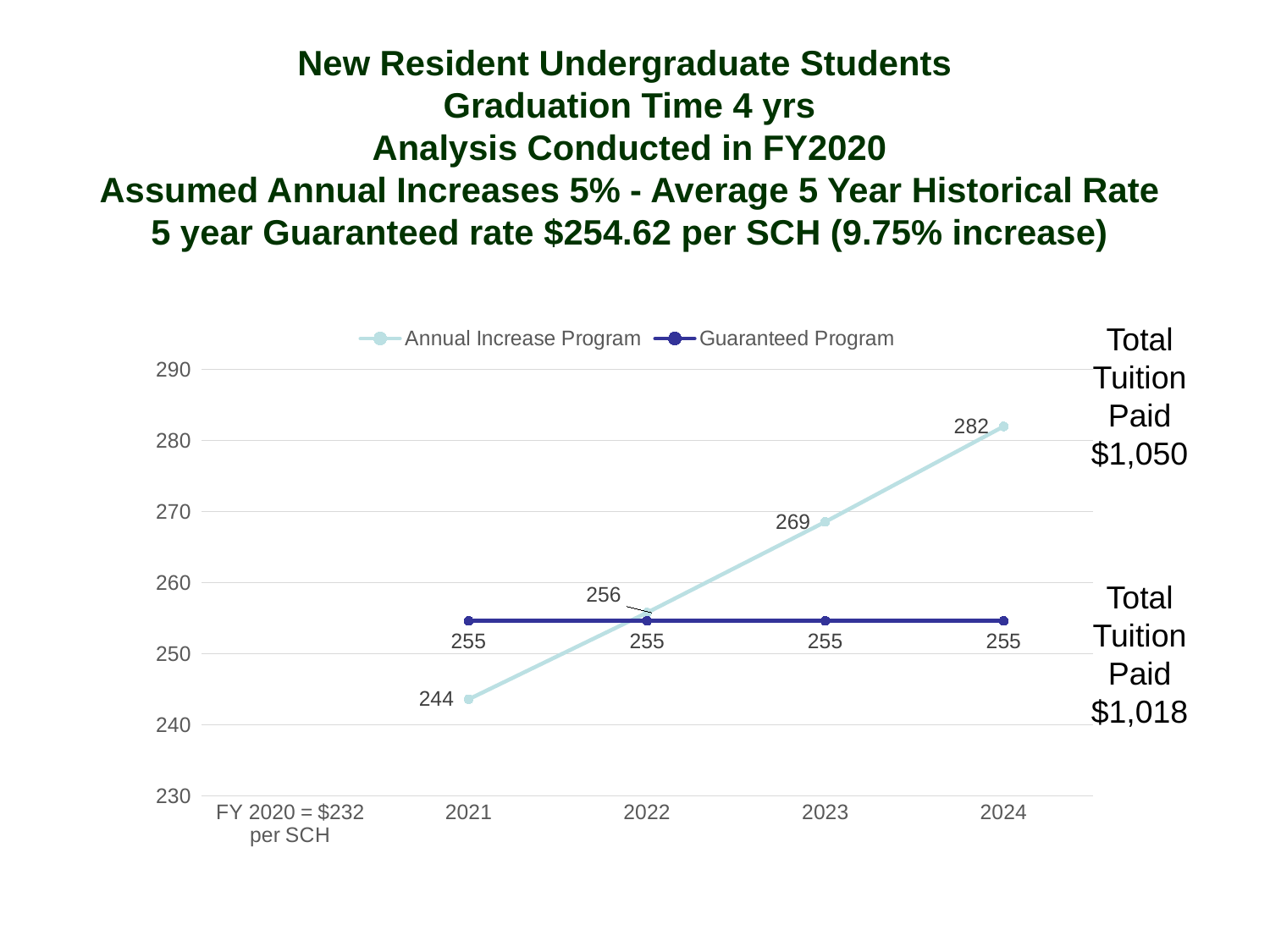
What is the difference between the Annual Increase Program values in 2024 and 2021? 38 What total tuition paid is shown next to the Guaranteed Program line? $1,018 How many data points are plotted for the Annual Increase Program series? 4 How many series does the legend list? 2 What type of chart is shown on the slide? line chart In 2023, which series has the larger value, Annual Increase Program or Guaranteed Program? Annual Increase Program What is the value of the Annual Increase Program in 2021? 244 In which year is the Annual Increase Program value lowest? 2021 What is the value of the Guaranteed Program in 2023? 255 In which year is the Annual Increase Program value highest? 2024 Does the Annual Increase Program line rise or fall from 2021 to 2024? rise What is the value of the Annual Increase Program in 2024? 282